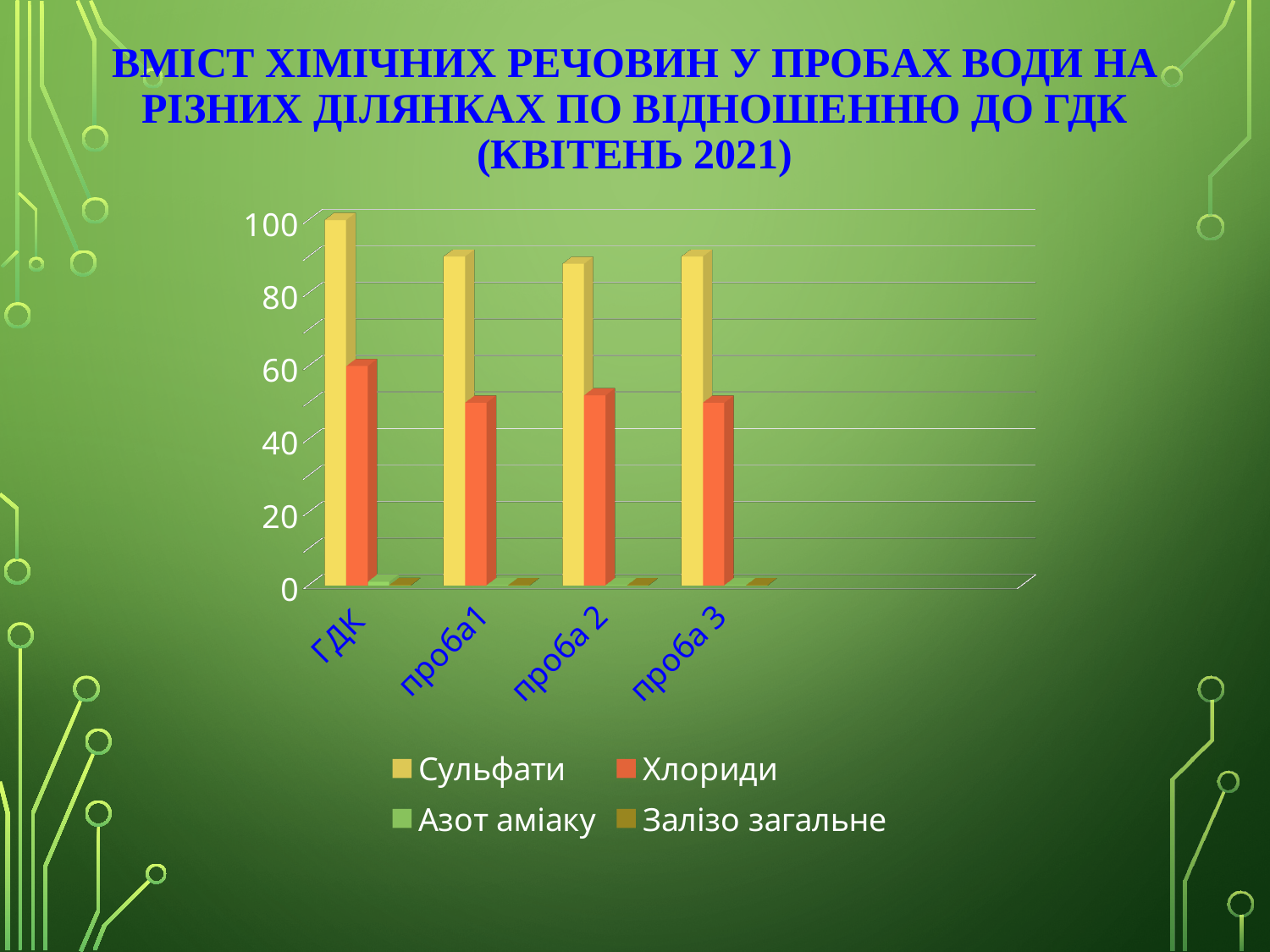
How many series does the chart legend list? 4 Which series is shown in red in the chart? Хлориди What kind of chart is shown on the slide? bar chart For проба 2, which is larger: Сульфати or Хлориди? Сульфати Which category has the highest Хлориди value? ГДК Is the Сульфати value for проба1 greater or less than 80? greater Is the Сульфати value for проба 3 greater or less than 100? less How many categories are shown on the x axis of the chart? 4 Which category has the highest Сульфати value? ГДК Is the Хлориди value for проба1 greater or less than 60? less Which is larger: the Сульфати value for ГДК or the Сульфати value for проба1? ГДК